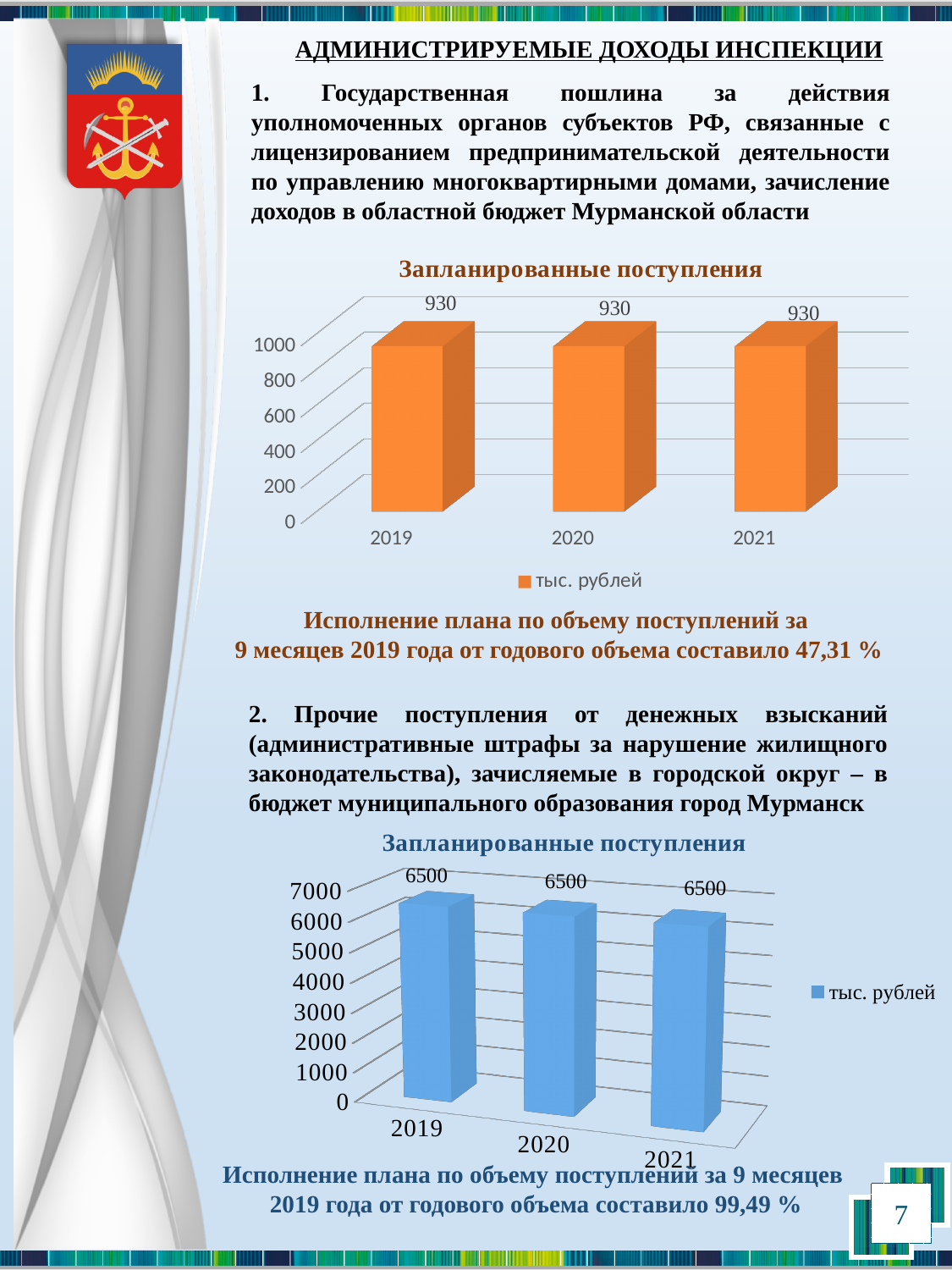
In the bottom chart (blue bars), what is the planned value for 2021? 6500 How many years (categories) are shown in the top chart (orange bars)? 3 How many series does the legend of the bottom chart (blue bars) list? 1 In the top chart (orange bars), what is the difference between the values for 2020 and 2019? 0 In the top chart (orange bars), what is the planned value for 2019? 930 What is the legend entry shown for the top chart (orange bars)? тыс. рублей In the bottom chart (blue bars), do the values rise, fall or stay the same from 2019 to 2021? stay the same In the bottom chart (blue bars), what is the planned value for 2020? 6500 In the top chart (orange bars), do the values rise, fall or stay the same across the years? stay the same What kind of chart is the bottom chart on the slide? bar chart In the top chart (orange bars), what is the planned value for 2021? 930 In the top chart (orange bars), is the value for 2020 greater or less than 800? greater